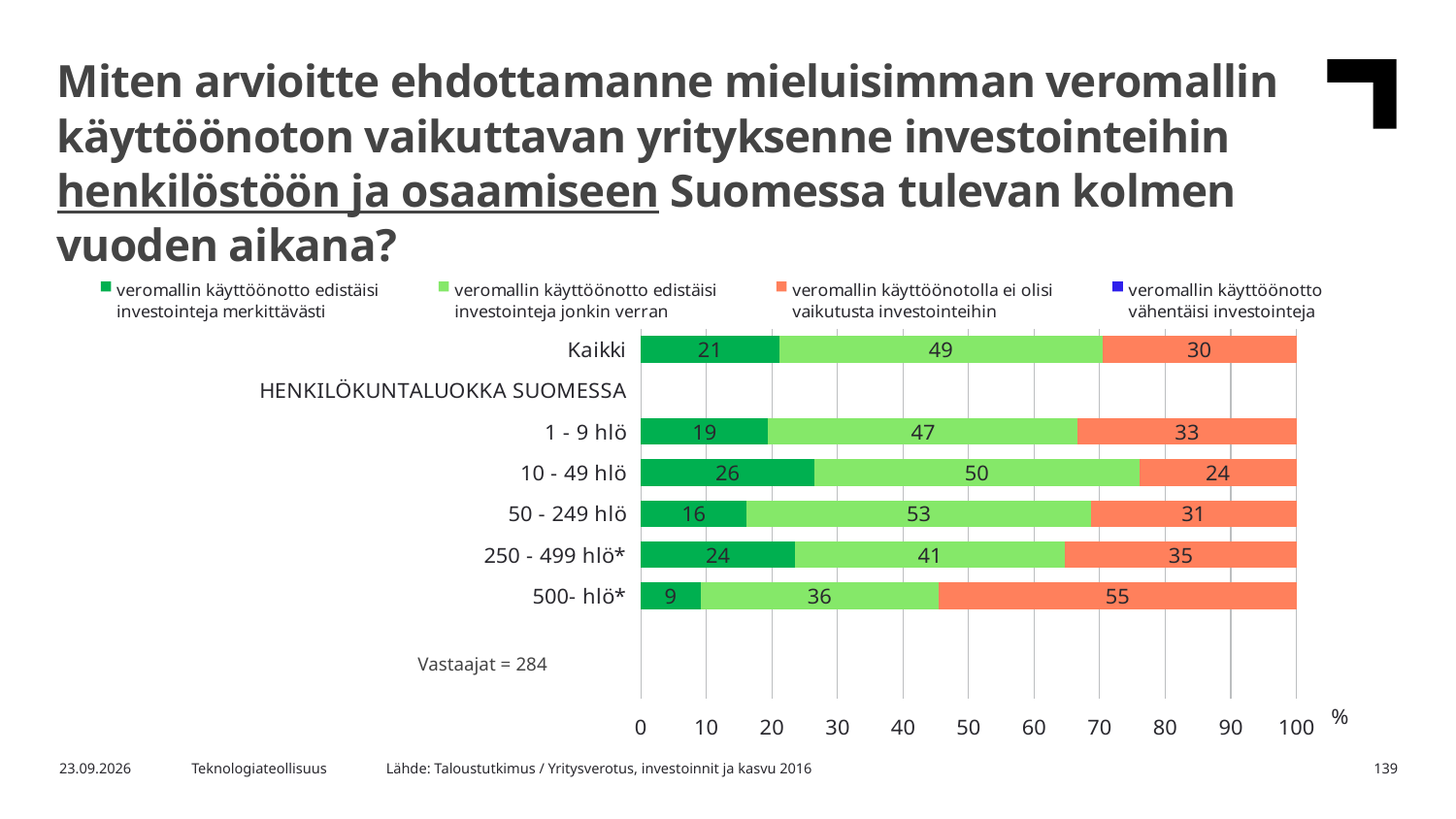
Which category has the highest value for 'veromallin käyttöönotto edistäisi investointeja merkittävästi'? 10 - 49 hlö Which is larger: the 'veromallin käyttöönotto edistäisi investointeja merkittävästi' value for 250 - 499 hlö* or for 1 - 9 hlö? 250 - 499 hlö* What is the total of the stacked bar for 1 - 9 hlö? 99 What is the value for 'veromallin käyttöönotto edistäisi investointeja jonkin verran' for 50 - 249 hlö? 53 What is the value for 'veromallin käyttöönotolla ei olisi vaikutusta investointeihin' for 500- hlö*? 55 Which category has the lowest value for 'veromallin käyttöönotto edistäisi investointeja jonkin verran'? 500- hlö* How many series does the legend list? 4 What kind of chart is shown on the slide? stacked bar chart How many respondents (Vastaajat) are stated on the slide? 284 How many bars with data are plotted in the chart? 6 What is the value for 'veromallin käyttöönotto edistäisi investointeja merkittävästi' in the Kaikki bar? 21 What is the difference between the 'veromallin käyttöönotolla ei olisi vaikutusta investointeihin' values for 500- hlö* and 10 - 49 hlö? 31